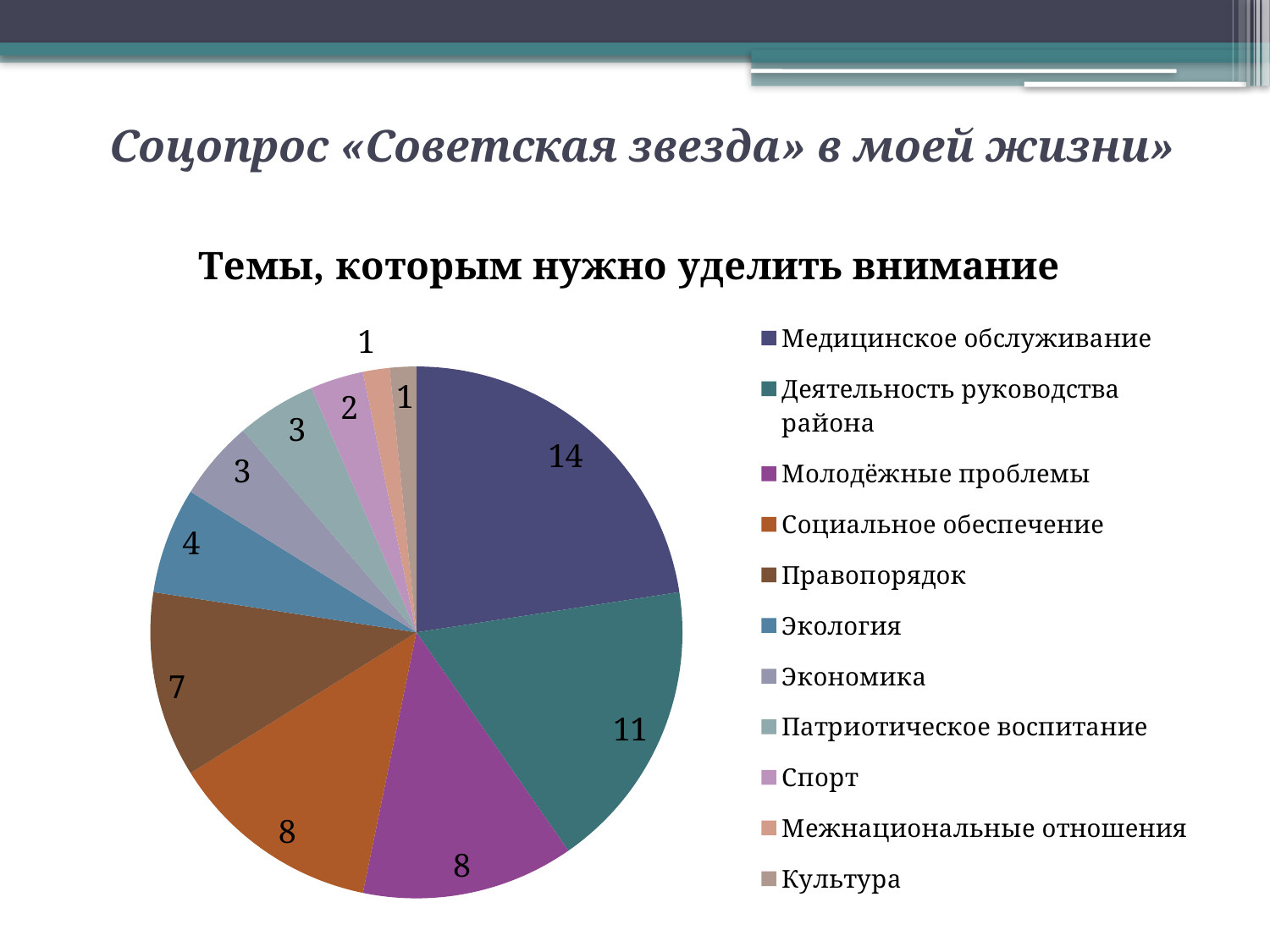
What is the difference between the values for Правопорядок and Экология? 3 What type of chart is shown on the slide? pie chart What is the difference between the values for Медицинское обслуживание and Деятельность руководства района? 3 What is the value for Экология? 4 What is the value for Медицинское обслуживание? 14 What is the title of the chart? Темы, которым нужно уделить внимание How many categories does the pie chart have? 11 What is the value for Деятельность руководства района? 11 What is the value for Спорт? 2 What is the value for Правопорядок? 7 Which category has the largest slice of the pie? Медицинское обслуживание Which is larger, the value for Молодёжные проблемы or the value for Экономика? Молодёжные проблемы